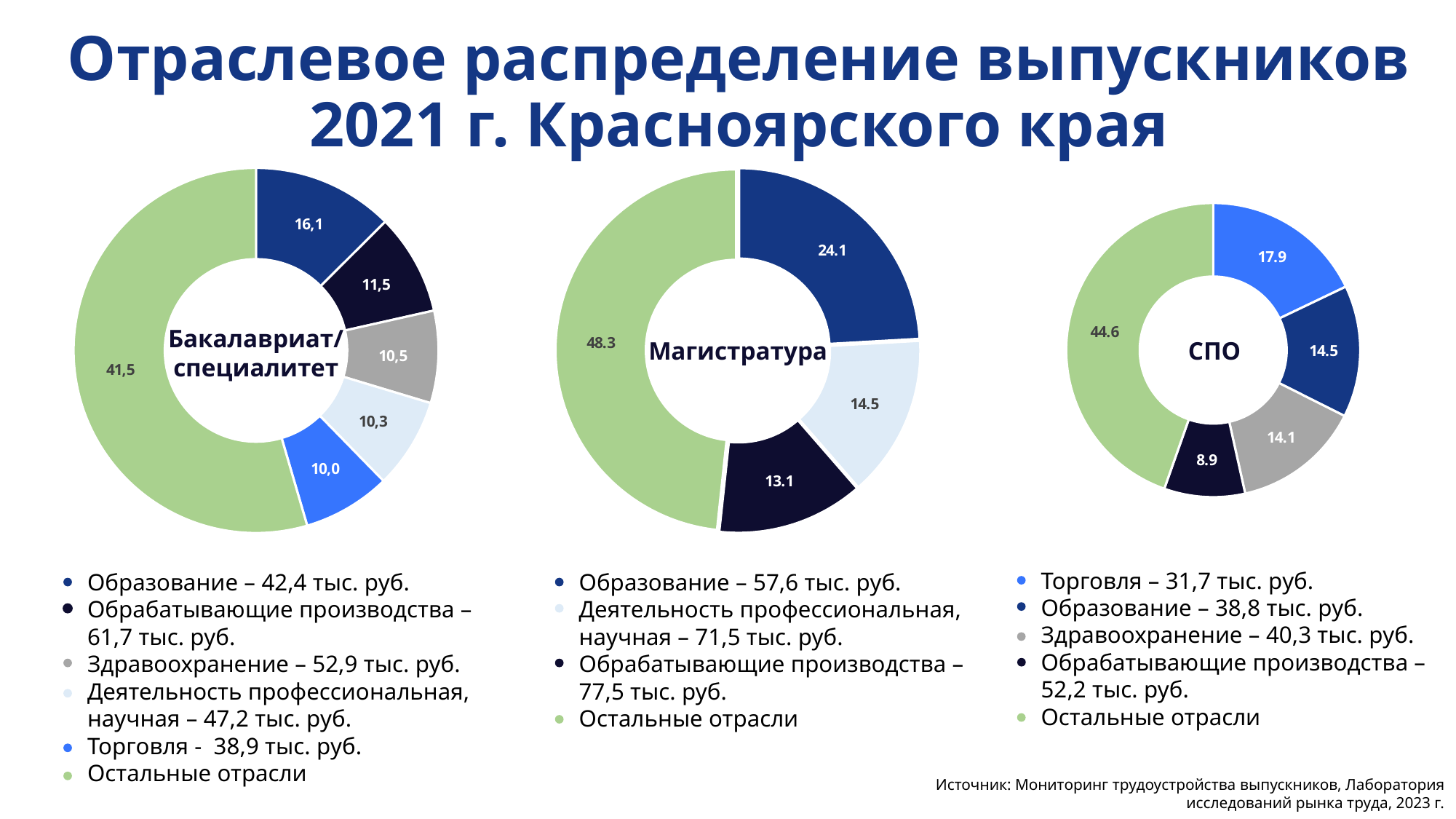
How many charts are shown on the slide? 3 How many slices does the Магистратура chart have? 4 In the Бакалавриат/специалитет chart, what is the value for Образование? 16,1 What type of chart is used on this slide? Donut (pie) chart In the СПО chart, which category has the smallest slice? Обрабатывающие производства In the СПО chart, which is larger: Торговля or Образование? Торговля In the Магистратура chart, which category has the largest slice? Остальные отрасли In the СПО chart, what is the value for Торговля? 17.9 In the Магистратура chart, what is the value for Обрабатывающие производства? 13.1 In the Бакалавриат/специалитет chart, what is the difference between the values for Образование and Торговля? 6,1 In the Магистратура chart, what is the value for Остальные отрасли? 48.3 How many slices does the Бакалавриат/специалитет chart have? 6